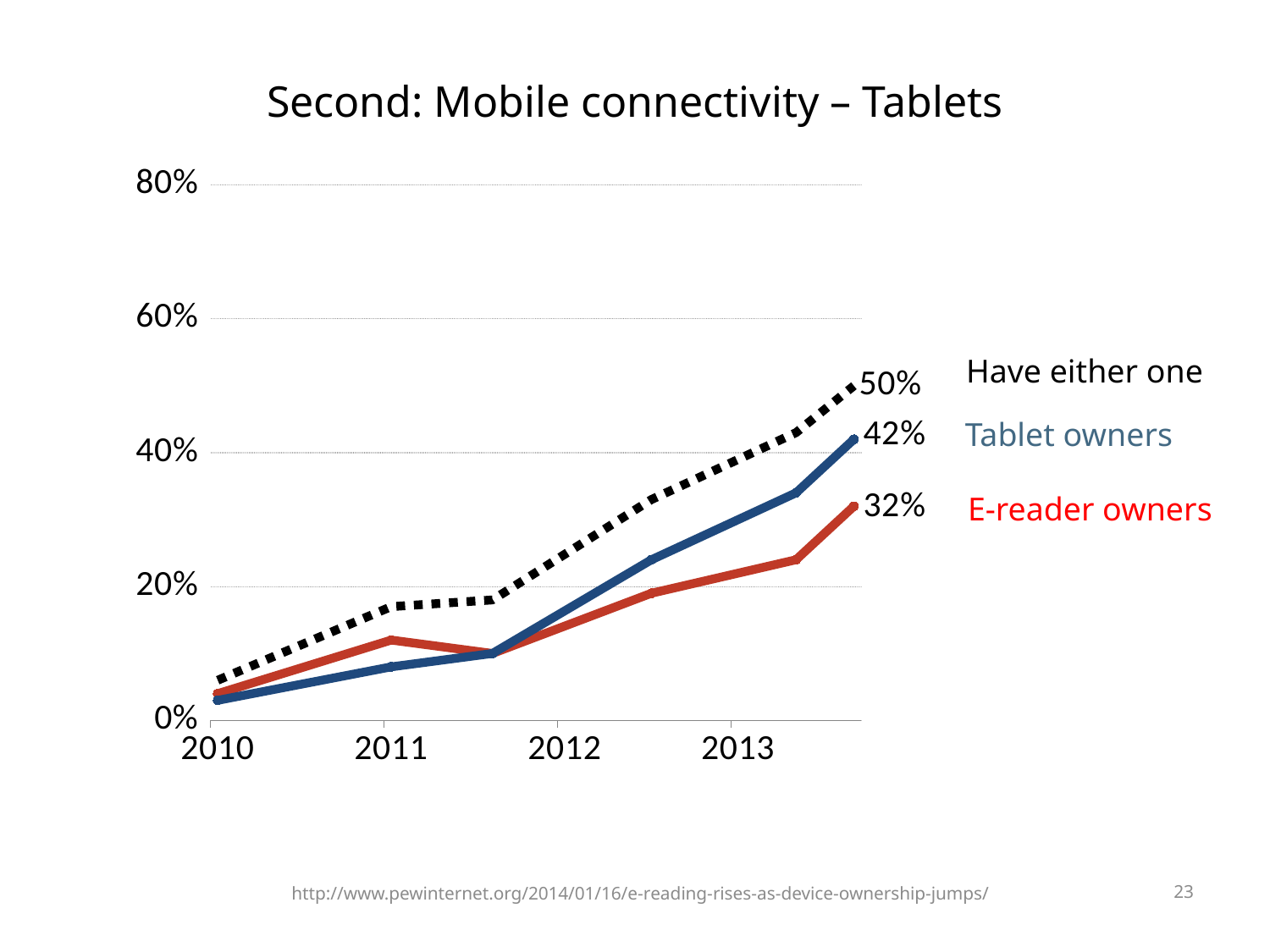
What is the final labelled value for Have either one? 50% Is the value for Tablet owners in 2010 greater or less than 20%? less What is the final labelled value for Tablet owners? 42% How many series does the chart show? 3 What kind of chart is shown on the slide? line chart What is the difference between the final labelled values for Tablet owners and E-reader owners? 10% Which series has the lowest final labelled value? E-reader owners What is the title of the chart? Second: Mobile connectivity – Tablets What is the final labelled value for E-reader owners? 32% At the end of the chart, which is larger: Tablet owners or E-reader owners? Tablet owners Do the values for Tablet owners generally rise or fall from 2010 to 2013? rise Which series has the highest final labelled value? Have either one